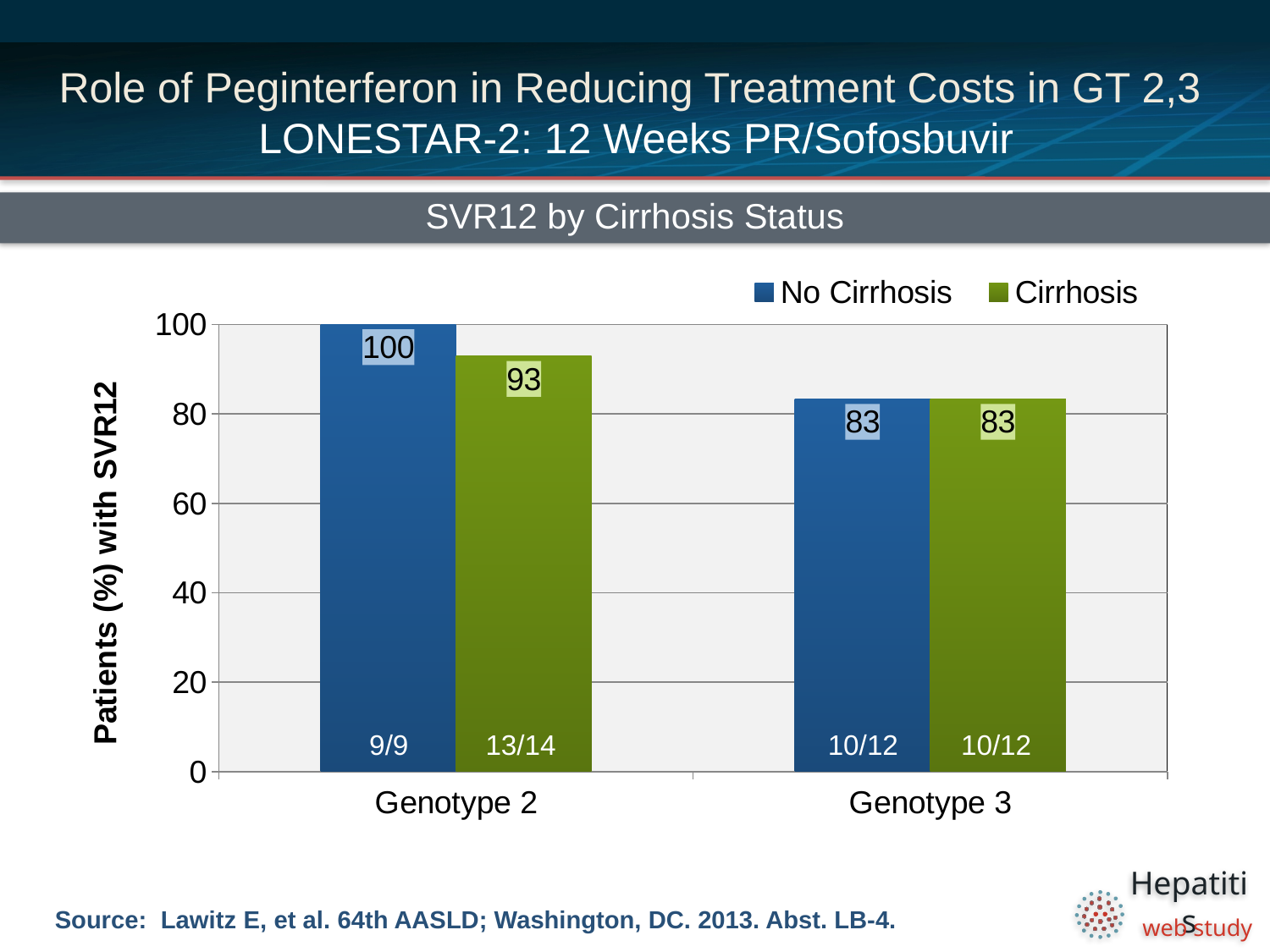
What is the SVR12 rate for patients with no cirrhosis in Genotype 2? 100 What is the SVR12 rate for patients with cirrhosis in Genotype 3? 83 What is the SVR12 rate for patients with cirrhosis in Genotype 2? 93 What is the label of the y axis? Patients (%) with SVR12 How many series does the legend list? 2 Which is larger: the No Cirrhosis value for Genotype 2 or the No Cirrhosis value for Genotype 3? No Cirrhosis value for Genotype 2 What fraction of patients is shown at the base of the Cirrhosis bar for Genotype 2? 13/14 What kind of chart is shown on the slide? Bar chart Is the Cirrhosis value for Genotype 3 greater or less than 60? greater What is the difference between the No Cirrhosis and Cirrhosis SVR12 values for Genotype 2? 7 Which bar has the highest SVR12 value on the chart? No Cirrhosis, Genotype 2 How many genotype categories are shown on the x axis? 2